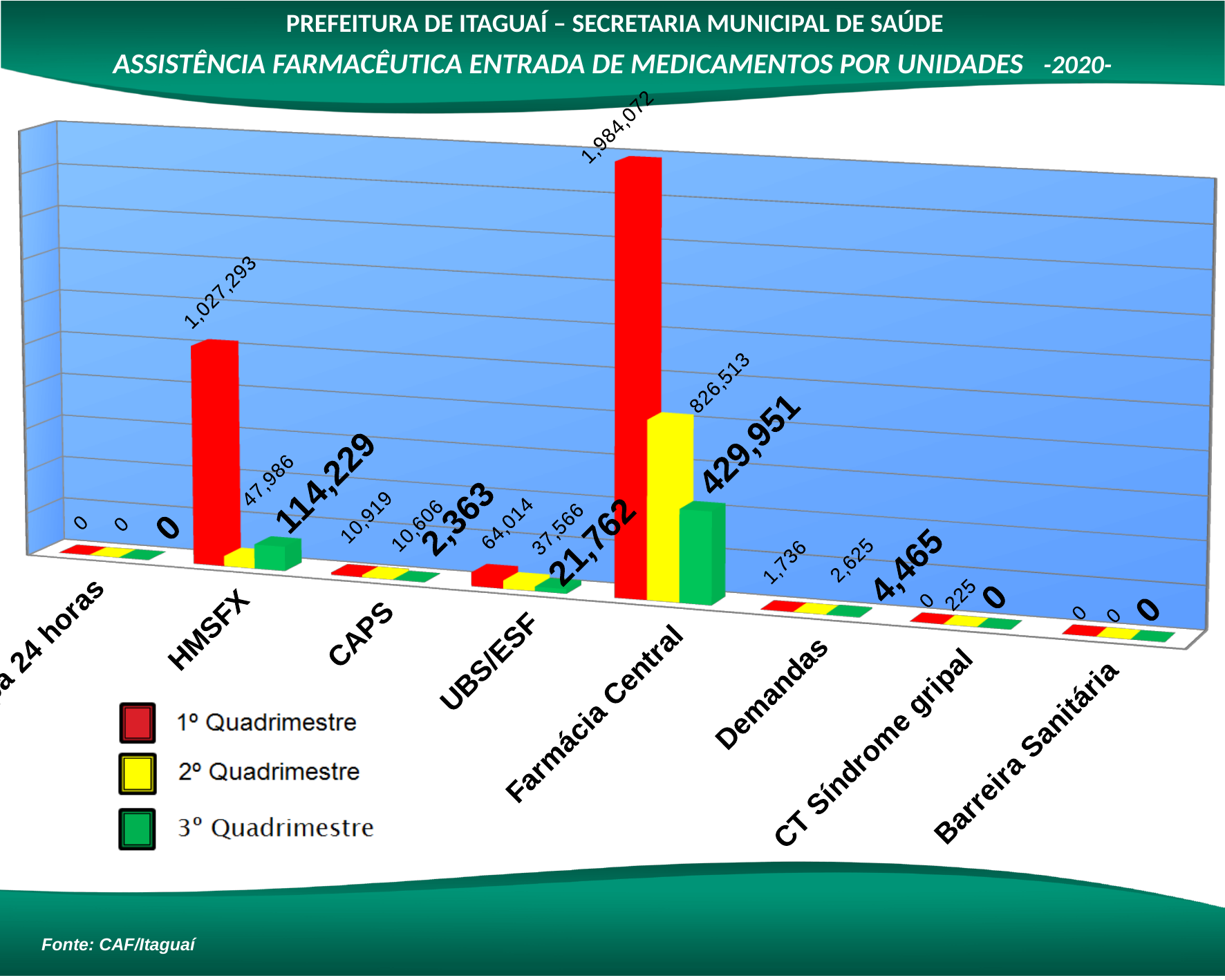
What is the difference between the 1º Quadrimestre and 2º Quadrimestre values for CAPS? 313 How many series does the legend list? 3 For HMSFX, which is larger: the 2º Quadrimestre value or the 3º Quadrimestre value? 3º Quadrimestre What is the total of the three Quadrimestre values for Demandas? 8,826 What is the value for CT Síndrome gripal in the 2º Quadrimestre? 225 What kind of chart is shown on the slide? Bar chart What is the value for HMSFX in the 3º Quadrimestre? 114,229 Which unit has the highest value in the 1º Quadrimestre? Farmácia Central What is the value for Farmácia Central in the 1º Quadrimestre? 1,984,072 How many units (categories) are shown on the x axis? 8 Which colour represents the 2º Quadrimestre in the legend? Yellow What is the difference between the 1º Quadrimestre and 2º Quadrimestre values for Farmácia Central? 1,157,559